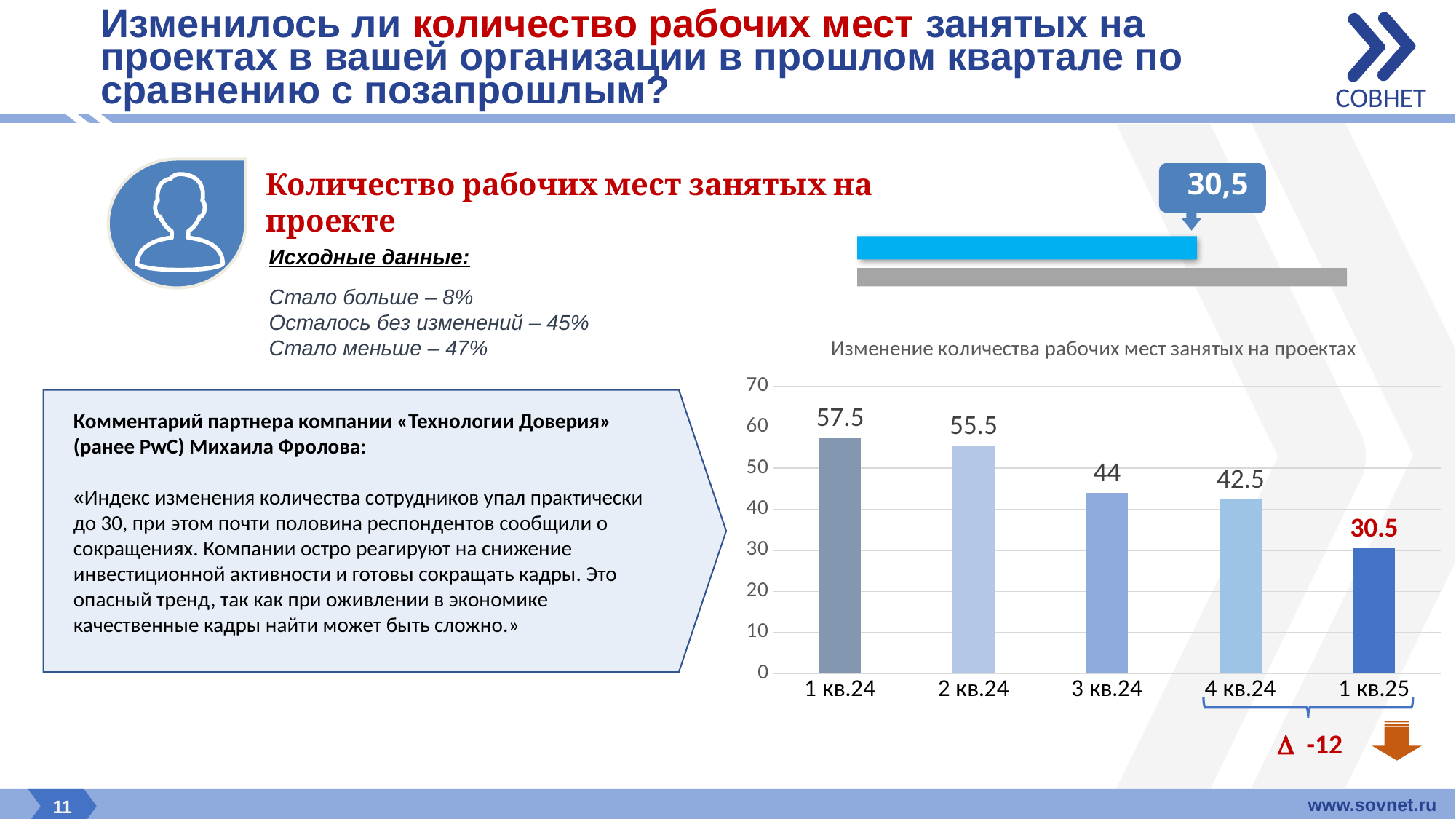
What is the difference between the values for 4 кв.24 and 1 кв.25? 12 Which quarter has the highest value in the chart? 1 кв.24 What is the difference between the values for 1 кв.24 and 2 кв.24? 2 Do the values rise or fall from 1 кв.24 to 1 кв.25? fall Which quarter has the lowest value in the chart? 1 кв.25 What is the value for 1 кв.24 in the chart 'Изменение количества рабочих мест занятых на проектах'? 57.5 What is the value for 1 кв.25 in the chart? 30.5 Which is larger, the value for 2 кв.24 or the value for 3 кв.24? 2 кв.24 What kind of chart is shown on the slide? bar chart What is the value for 3 кв.24 in the chart? 44 Is the value for 4 кв.24 greater or less than 40? greater How many quarters are shown on the x axis of the chart? 5